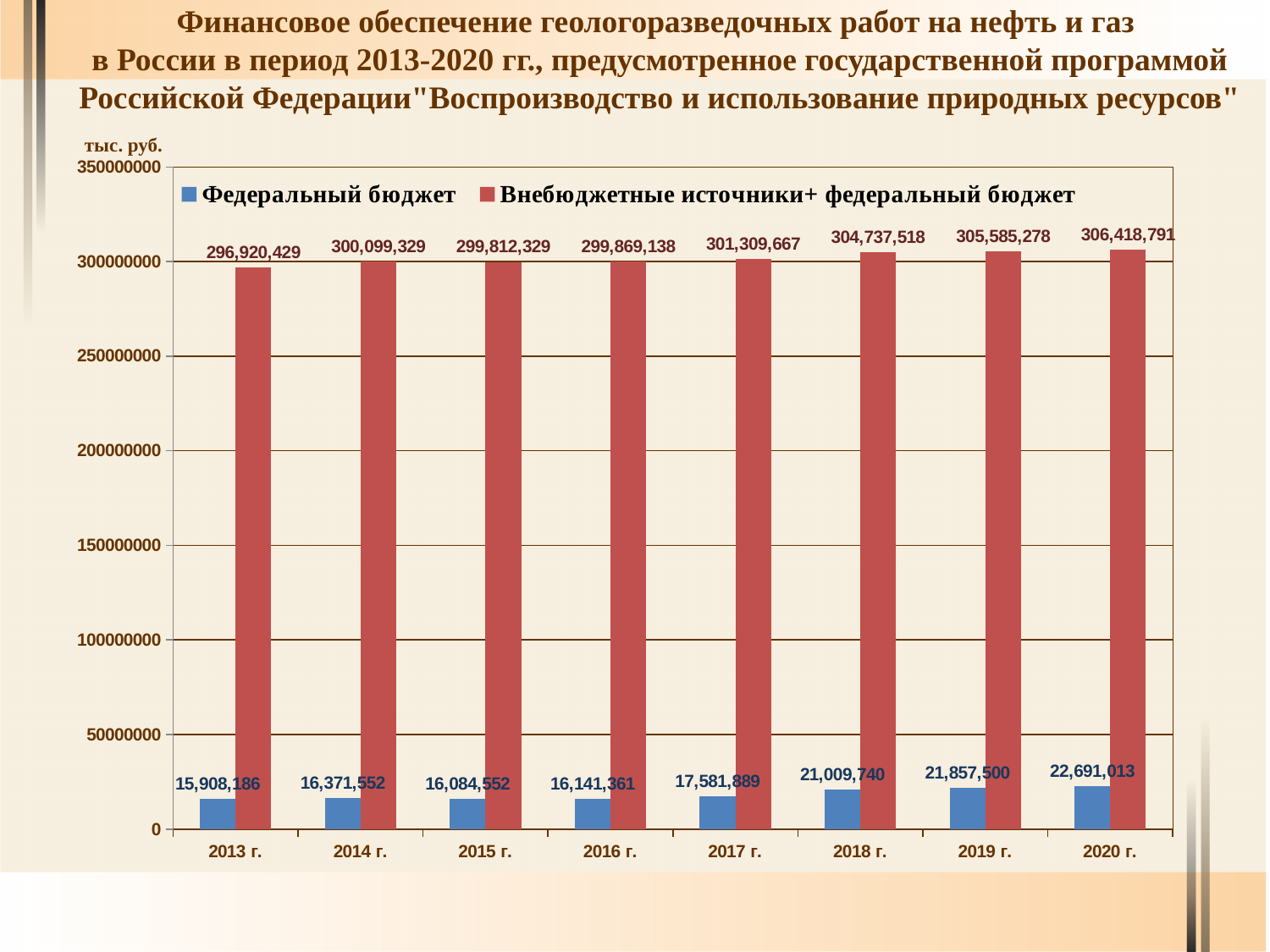
How many series does the legend list? 2 What kind of chart is shown on the slide? bar chart How many years are shown on the x axis? 8 What is the value for Федеральный бюджет in 2013 г.? 15,908,186 Do the Федеральный бюджет values generally rise or fall from 2013 г. to 2020 г.? rise Is the value for Внебюджетные источники+ федеральный бюджет in 2013 г. greater or less than 250000000? greater In which year is the Внебюджетные источники+ федеральный бюджет value lowest? 2013 г. In which year is the Федеральный бюджет value highest? 2020 г. What is the value for Внебюджетные источники+ федеральный бюджет in 2020 г.? 306,418,791 Which is larger, the Федеральный бюджет value for 2014 г. or for 2015 г.? 2014 г. What is the value for Внебюджетные источники+ федеральный бюджет in 2017 г.? 301,309,667 What is the difference between the Федеральный бюджет values for 2020 г. and 2013 г.? 6,782,827